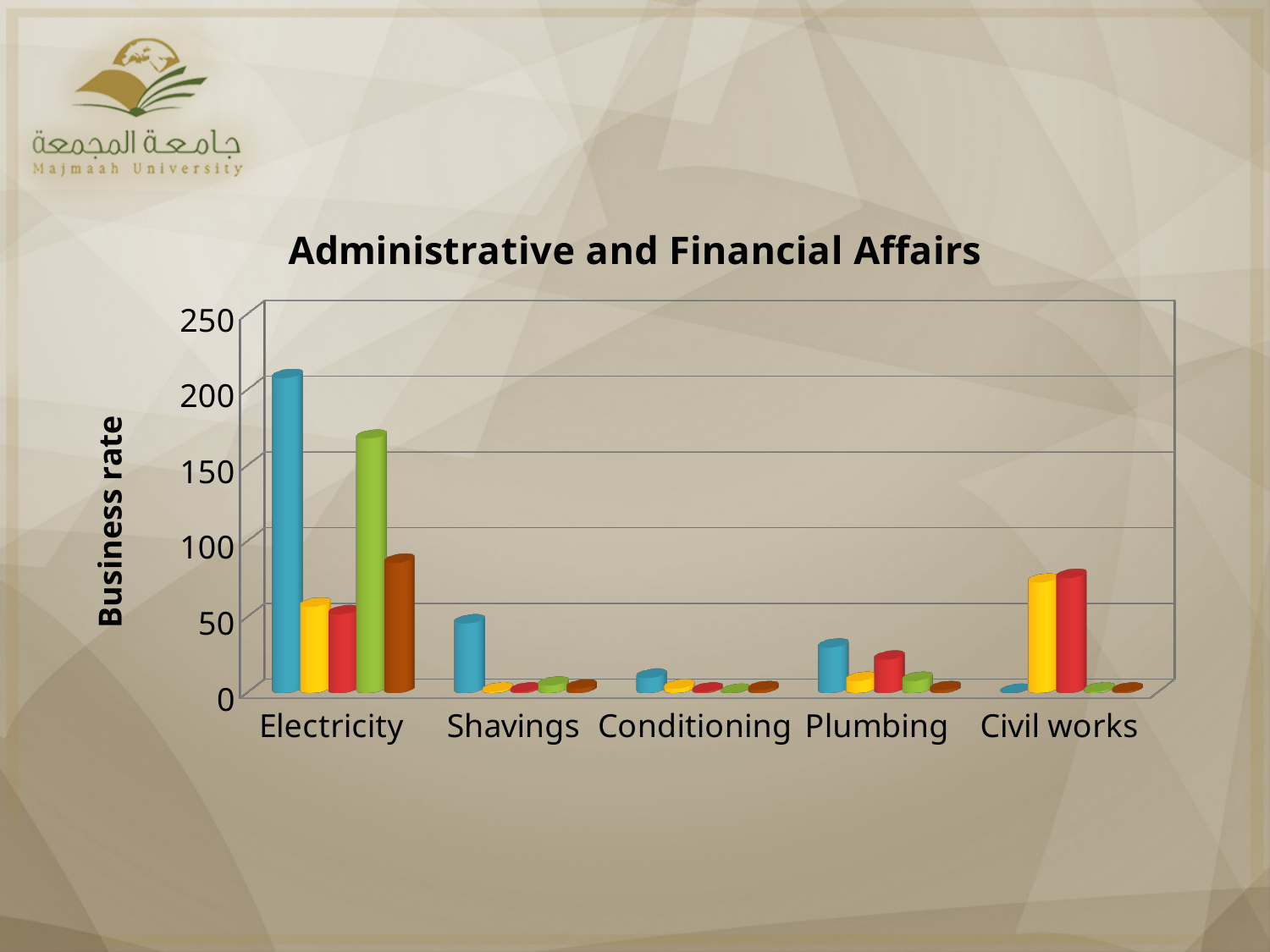
Which category contains the tallest bar in the chart? Electricity What type of chart is shown on the slide? bar chart Which is larger, the blue bar for Electricity or the blue bar for Shavings? Electricity What is the title of the chart? Administrative and Financial Affairs How many categories are shown on the x axis of the chart? 5 What is the label on the vertical axis of the chart? Business rate Is the value of the blue bar for Plumbing greater or less than 50? less Is the value of the brown bar for Electricity greater or less than 100? less How many bars are plotted for each category in the chart? 5 Is the value of the green bar for Electricity greater or less than 150? greater